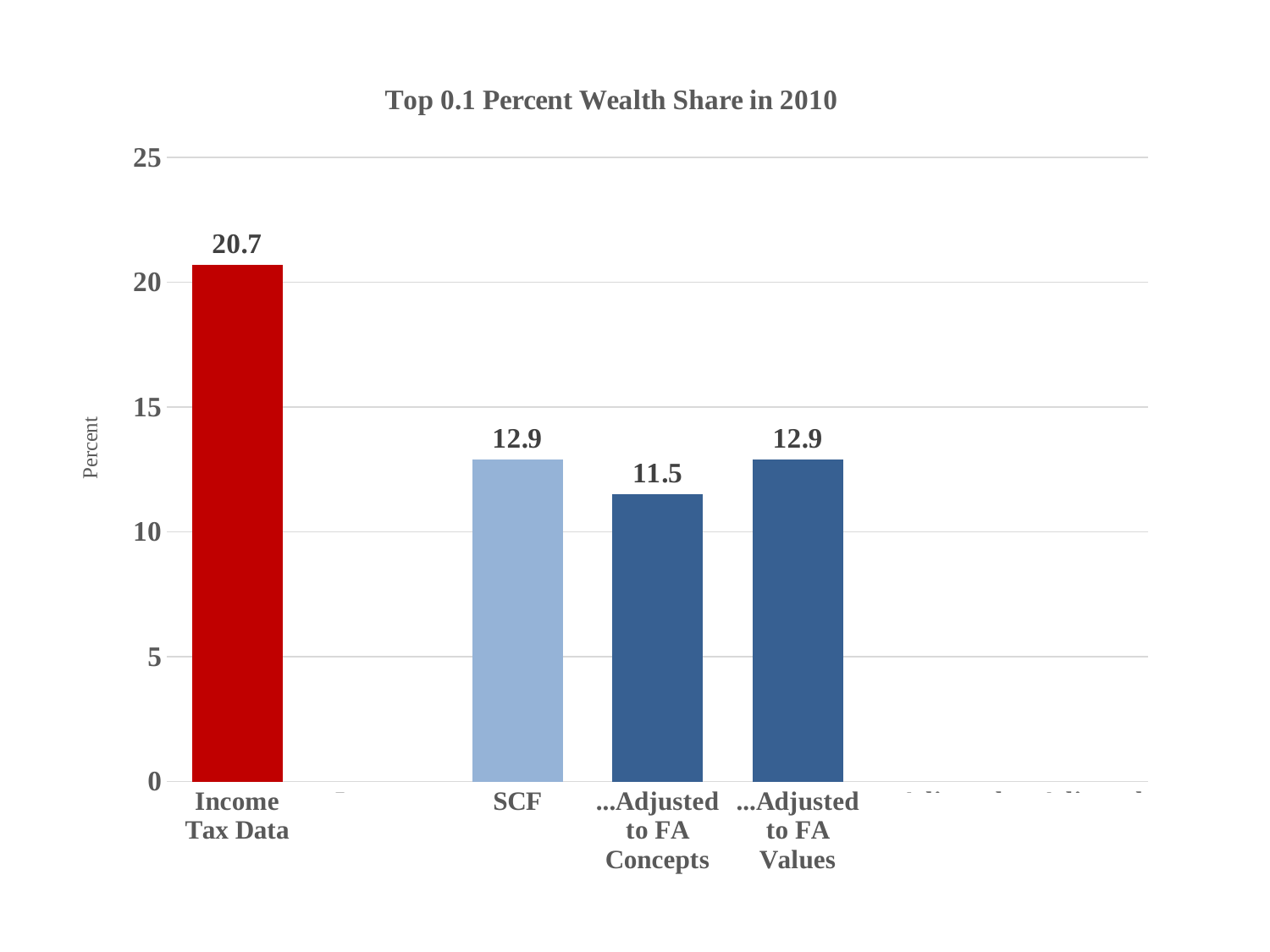
What is the value for Income Tax Data? 20.7 What is the value for ...Adjusted to FA Concepts? 11.5 What is the title of the chart? Top 0.1 Percent Wealth Share in 2010 Is the value for Income Tax Data greater or less than 20? greater What is the value for ...Adjusted to FA Values? 12.9 What is the difference between the values for SCF and ...Adjusted to FA Concepts? 1.4 Which category has the highest value? Income Tax Data What is the difference between the values for Income Tax Data and SCF? 7.8 Which category has the lowest value? ...Adjusted to FA Concepts What kind of chart is shown on the slide? bar chart What is the value for SCF? 12.9 Which is larger, the value for Income Tax Data or the value for ...Adjusted to FA Values? Income Tax Data